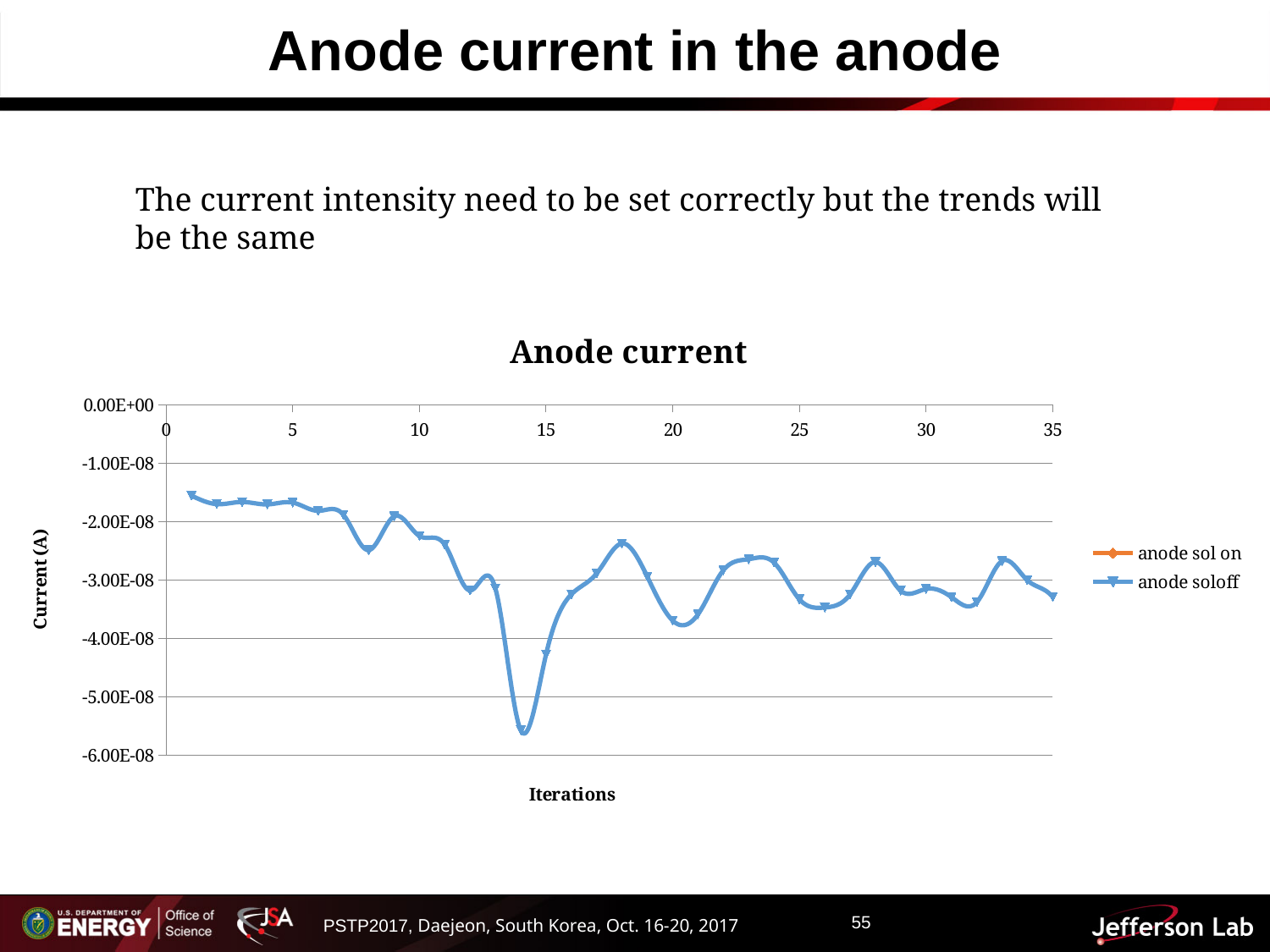
What is the label of the y axis of the chart? Current (A) Do the values of the anode soloff series rise or fall from iteration 1 to iteration 14? fall What is the title of the chart? Anode current Is the value of the anode soloff series at iteration 1 greater or less than -2.00E-08? greater What kind of chart is shown on the slide? line chart Which is larger for the anode soloff series: the value at iteration 1 or the value at iteration 14? iteration 1 Is the value of the anode soloff series at iteration 18 greater or less than -3.00E-08? greater Which is larger for the anode soloff series: the value at iteration 9 or the value at iteration 12? iteration 9 Is the value of the anode soloff series at iteration 14 greater or less than -5.00E-08? less At which iteration does the anode soloff series reach its lowest value? 14 How many series does the legend of the chart list? 2